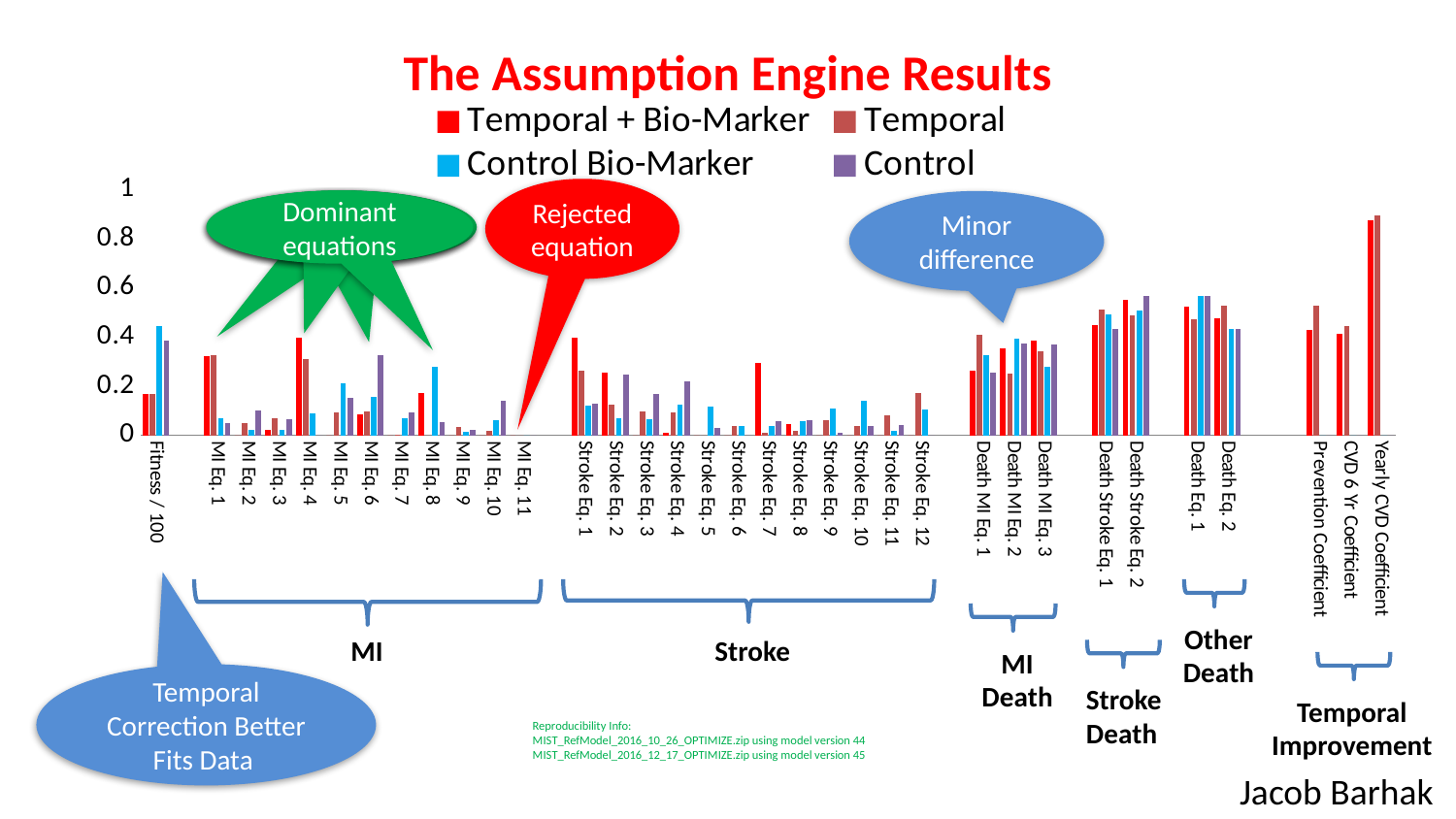
Is the Temporal + Bio-Marker value for MI Eq. 11 greater or less than 0.2? less For the Control Bio-Marker series, which is larger: Death Eq. 1 or MI Eq. 1? Death Eq. 1 Is the Temporal value for Yearly CVD Coefficient greater or less than 0.8? greater Is the Temporal + Bio-Marker value for MI Eq. 4 greater or less than 0.2? greater Which category has the tallest bars in the chart? Yearly CVD Coefficient Which series is shown in bright red in the legend? Temporal + Bio-Marker What kind of chart is shown on the slide? bar chart How many series does the legend list? 4 What is the title of the chart? The Assumption Engine Results For the Temporal series, which is larger: Yearly CVD Coefficient or Prevention Coefficient? Yearly CVD Coefficient